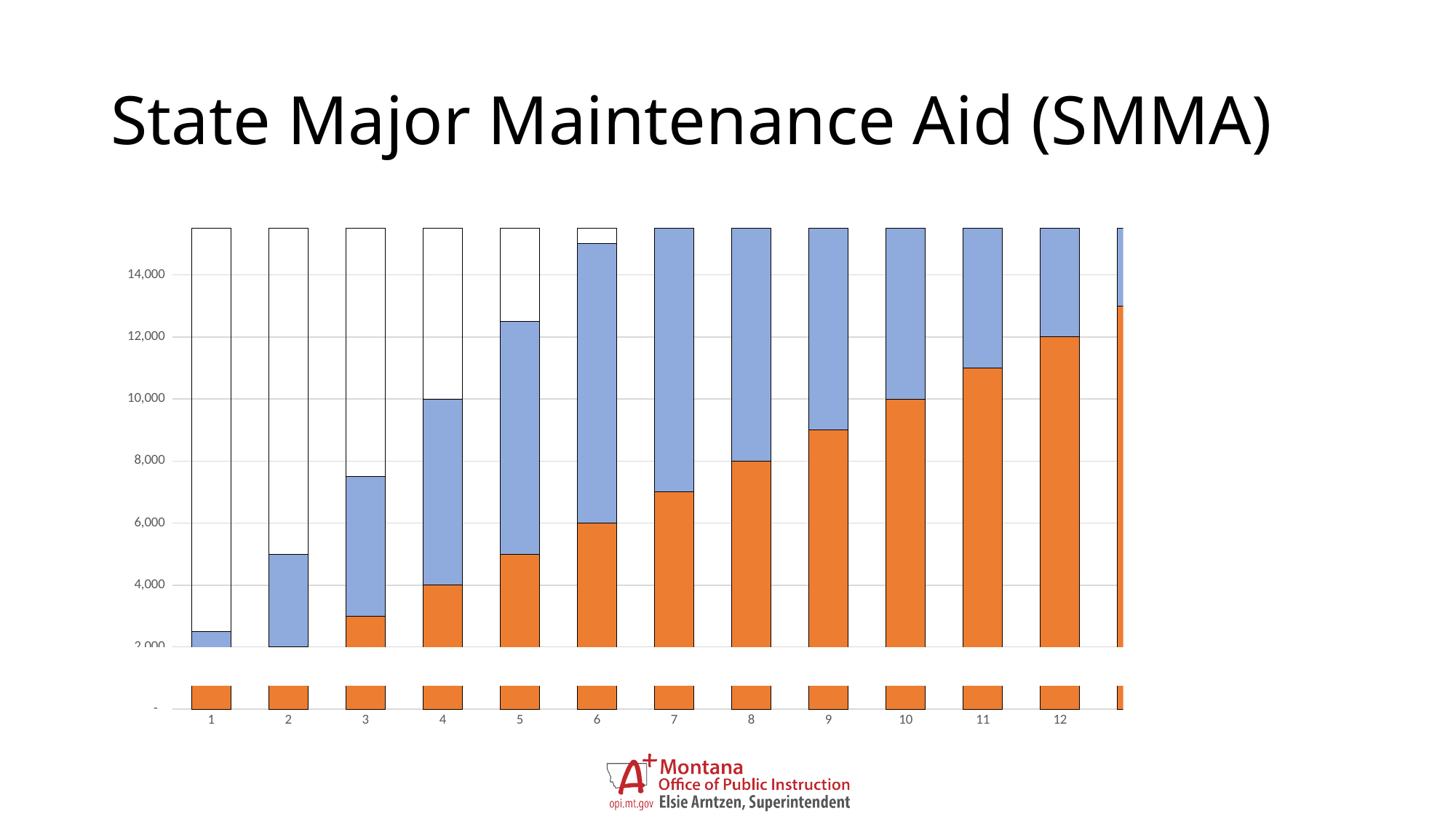
What is the value at the top of the blue segment for category 4? 10,000 What is the value at the top of the orange segment for category 4? 4,000 Is the top of the blue segment for category 5 greater or less than 12,000? greater What kind of chart is shown on the slide? bar chart Among the labeled categories, which has the tallest orange segment? 12 How many categories are labeled on the x axis of the chart? 12 Which has a taller orange segment, category 9 or category 5? 9 Do the orange segments rise or fall from category 1 to category 12? rise Is the top of the orange segment for category 3 greater or less than 4,000? less What is the value at the top of the orange segment for category 12? 12,000 Is the top of the orange segment for category 11 greater or less than 10,000? greater What is the value at the top of the orange segment for category 8? 8,000